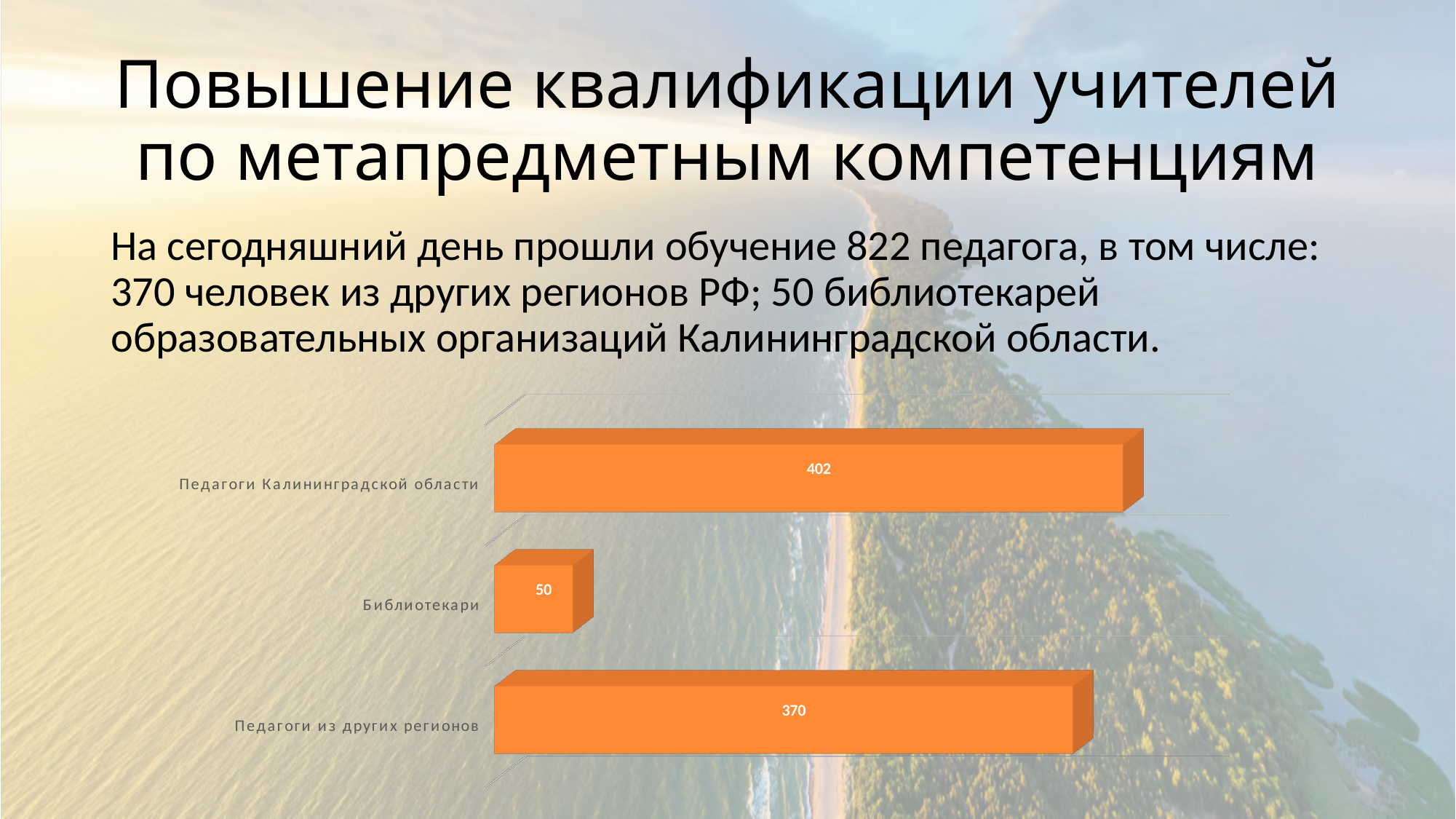
What colour are the bars in the chart? Orange What is the value for Педагоги Калининградской области? 402 Which category has the lowest value? Библиотекари What is the value for Библиотекари? 50 What is the value for Педагоги из других регионов? 370 How many categories are shown in the chart? 3 What is the difference between the values for Педагоги Калининградской области and Педагоги из других регионов? 32 What is the difference between the values for Педагоги из других регионов and Библиотекари? 320 Which is larger: the value for Библиотекари or the value for Педагоги из других регионов? Педагоги из других регионов Which is larger: the value for Педагоги Калининградской области or the value for Педагоги из других регионов? Педагоги Калининградской области What kind of chart is shown on the slide? Bar chart Which category has the highest value? Педагоги Калининградской области